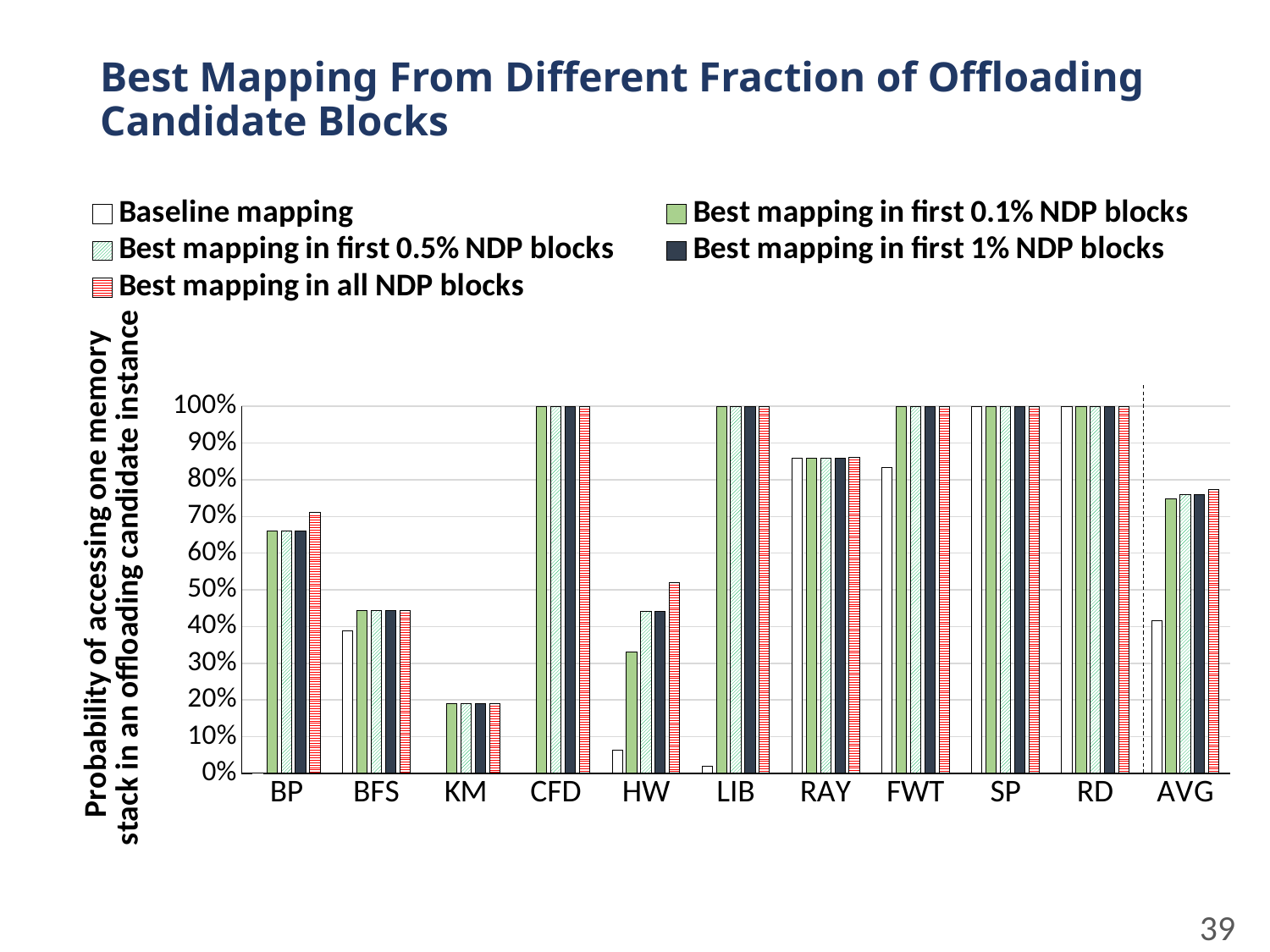
How many series does the legend list? 5 Is the value of Baseline mapping for BP greater or less than 10%? less What kind of chart is shown on the slide? bar chart For HW, which is larger: Baseline mapping or Best mapping in first 0.1% NDP blocks? Best mapping in first 0.1% NDP blocks Is the value of Baseline mapping for AVG greater or less than 50%? less What is the value of Best mapping in all NDP blocks for CFD? 100% Which category has the lowest value for Best mapping in first 1% NDP blocks? KM What is the value of Best mapping in first 1% NDP blocks for RD? 100% Is the value of Best mapping in first 0.1% NDP blocks for KM greater or less than 10%? greater What is the value of Baseline mapping for SP? 100% How many categories are shown along the x axis? 11 What is the title of the y axis? Probability of accessing one memory stack in an offloading candidate instance